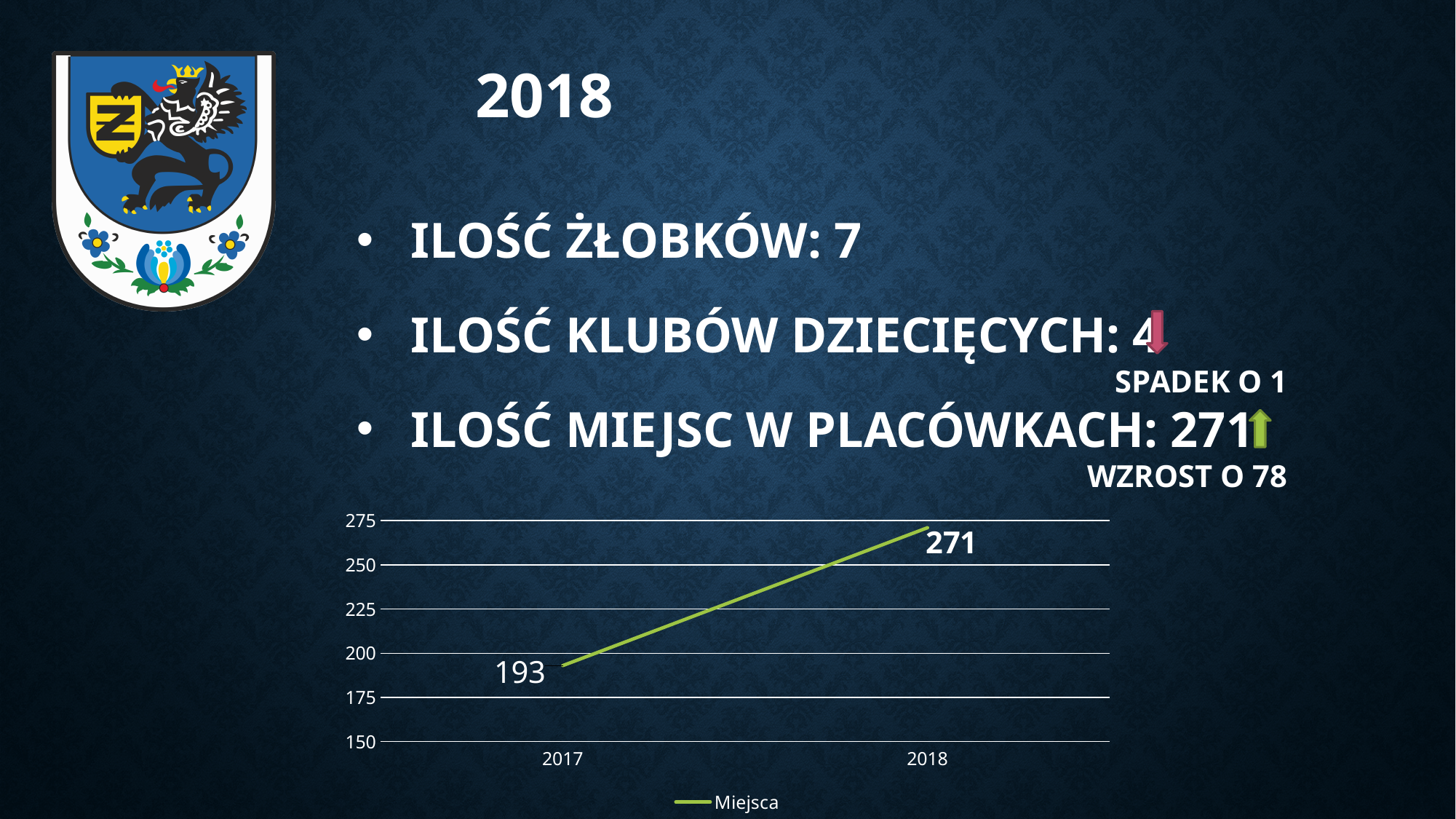
How many data points are plotted in the chart? 2 Is the value for 2017 greater or less than 200? less What kind of chart is shown on the slide? line chart What is the value for 2018 in the chart? 271 How many series does the chart legend list? 1 Which year has the higher value in the chart? 2018 What is the value for 2017 in the chart? 193 What is the name of the series shown in the chart legend? Miejsca What is the difference between the 2018 and 2017 values in the chart? 78 Does the line rise or fall from 2017 to 2018? rises Which year has the lower value in the chart? 2017 Is the value for 2018 greater or less than 250? greater